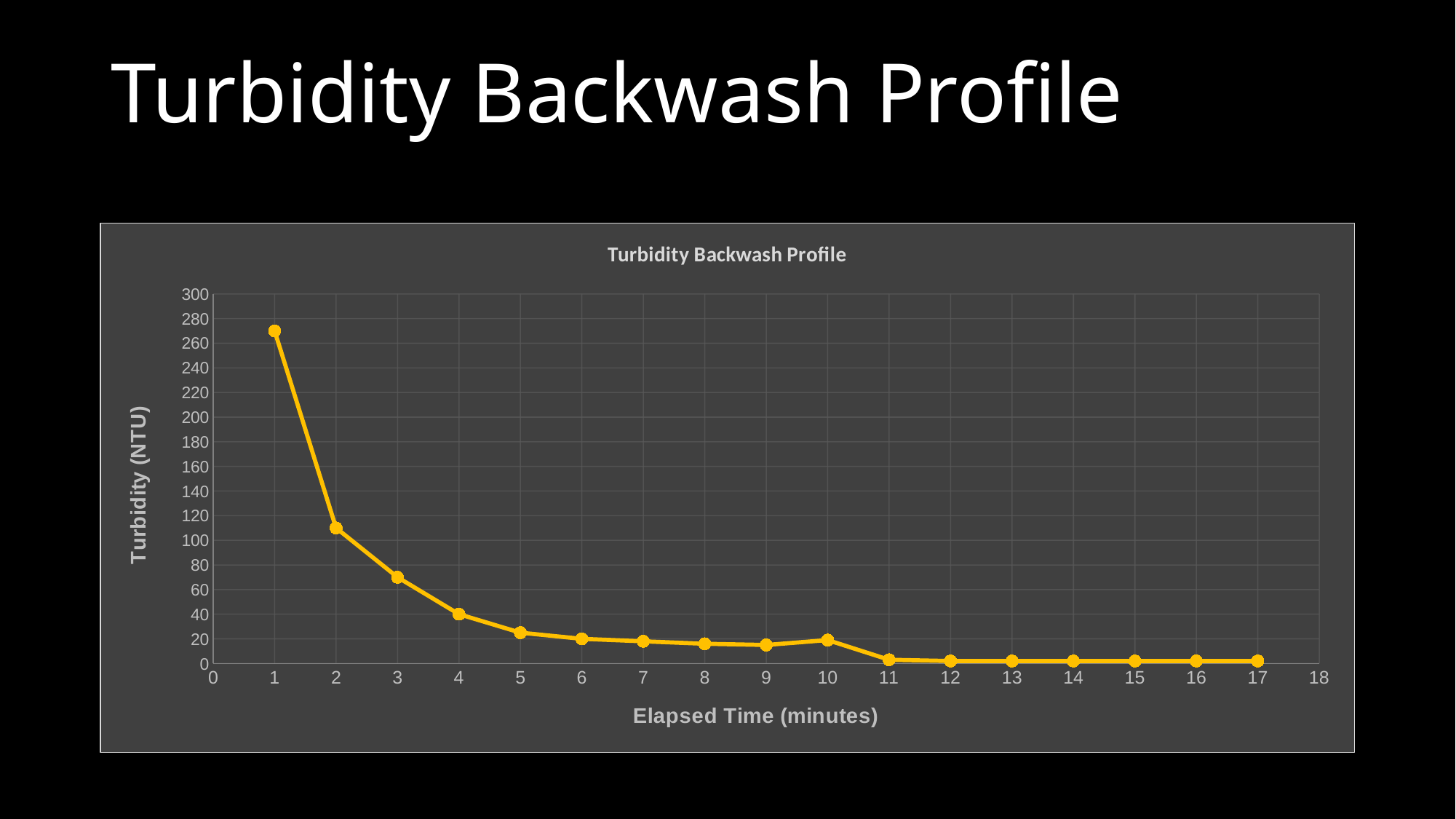
What is the label of the x axis? Elapsed Time (minutes) How many data points are plotted on the line? 17 Which has the higher turbidity, 2 minutes or 5 minutes? 2 minutes What kind of chart is shown on the slide? line chart At which elapsed time is turbidity highest? 1 Which has the higher turbidity, 10 minutes or 12 minutes? 10 minutes Is the turbidity at 2 minutes greater or less than 100? greater Is the turbidity at 11 minutes greater or less than 20? less Do turbidity values generally rise or fall as elapsed time increases? fall What is the title of the chart? Turbidity Backwash Profile Is the turbidity at 1 minute greater or less than 260? greater